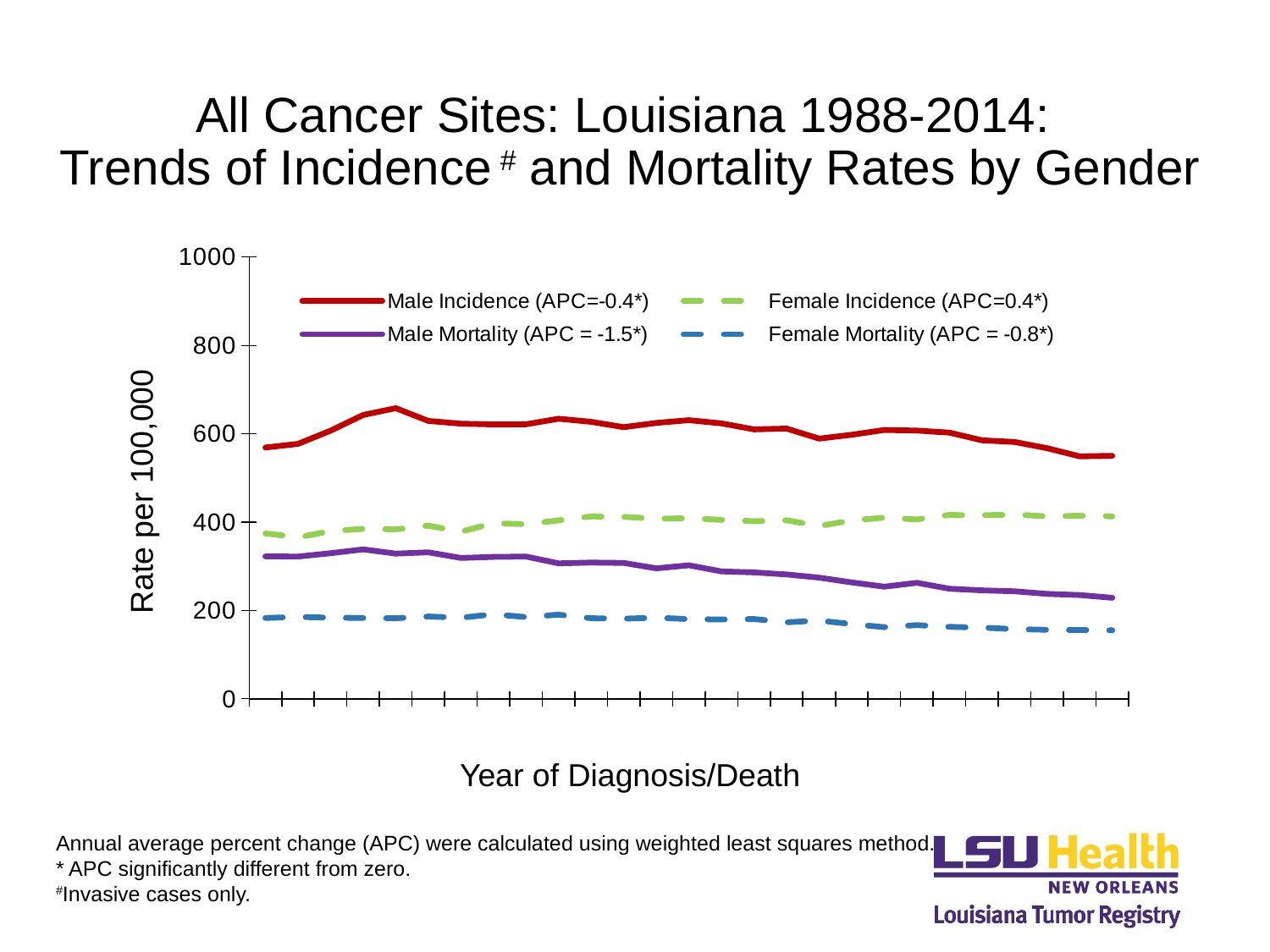
Which is larger at the end of the period, Female Incidence or Male Mortality? Female Incidence Which series has the highest values throughout the chart? Male Incidence How many series does the legend list? 4 Is the Male Mortality line greater or less than 400 across the whole period? less What is the label of the y axis? Rate per 100,000 Which series has the lowest values throughout the chart? Female Mortality Is the Male Incidence line greater or less than 400 across the whole period? greater Does the Male Mortality line rise or fall over the period shown? fall Does the Female Incidence line rise or fall over the period shown? rise What APC value is shown in the legend for Male Mortality? -1.5* Is the Female Mortality line greater or less than 200 across the whole period? less What kind of chart is shown on the slide? line chart